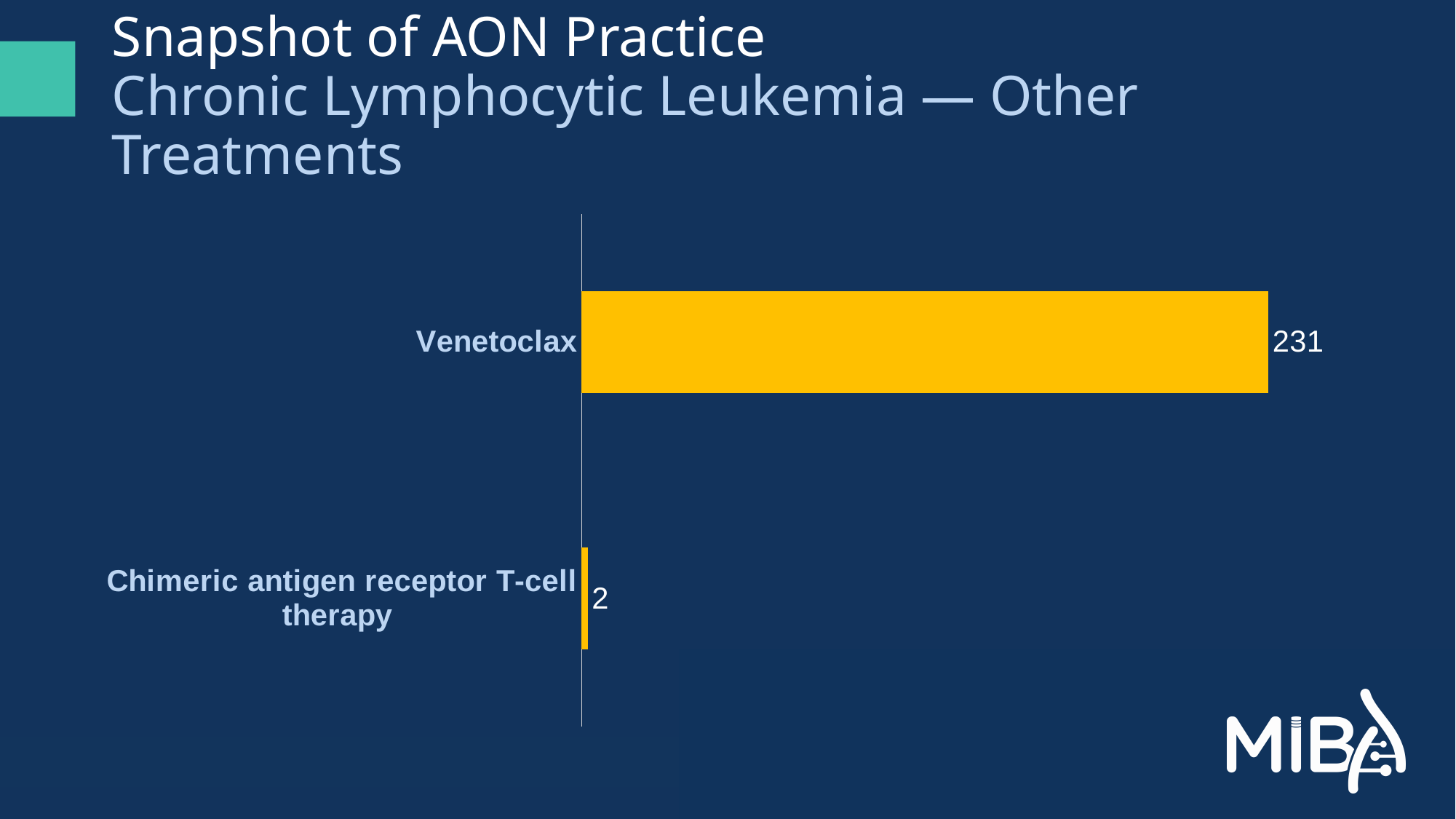
Which category has the highest value? Venetoclax What is the title of the slide? Snapshot of AON Practice Chronic Lymphocytic Leukemia — Other Treatments What is the total of the two values shown in the chart? 233 What is the value for Chimeric antigen receptor T-cell therapy? 2 Which category has the lowest value? Chimeric antigen receptor T-cell therapy What colour are the bars in the chart? Yellow How many categories are shown in the chart? 2 What is the difference between the values for Venetoclax and Chimeric antigen receptor T-cell therapy? 229 Which is larger, the value for Venetoclax or the value for Chimeric antigen receptor T-cell therapy? Venetoclax What is the value for Venetoclax? 231 What kind of chart is shown on the slide? Bar chart